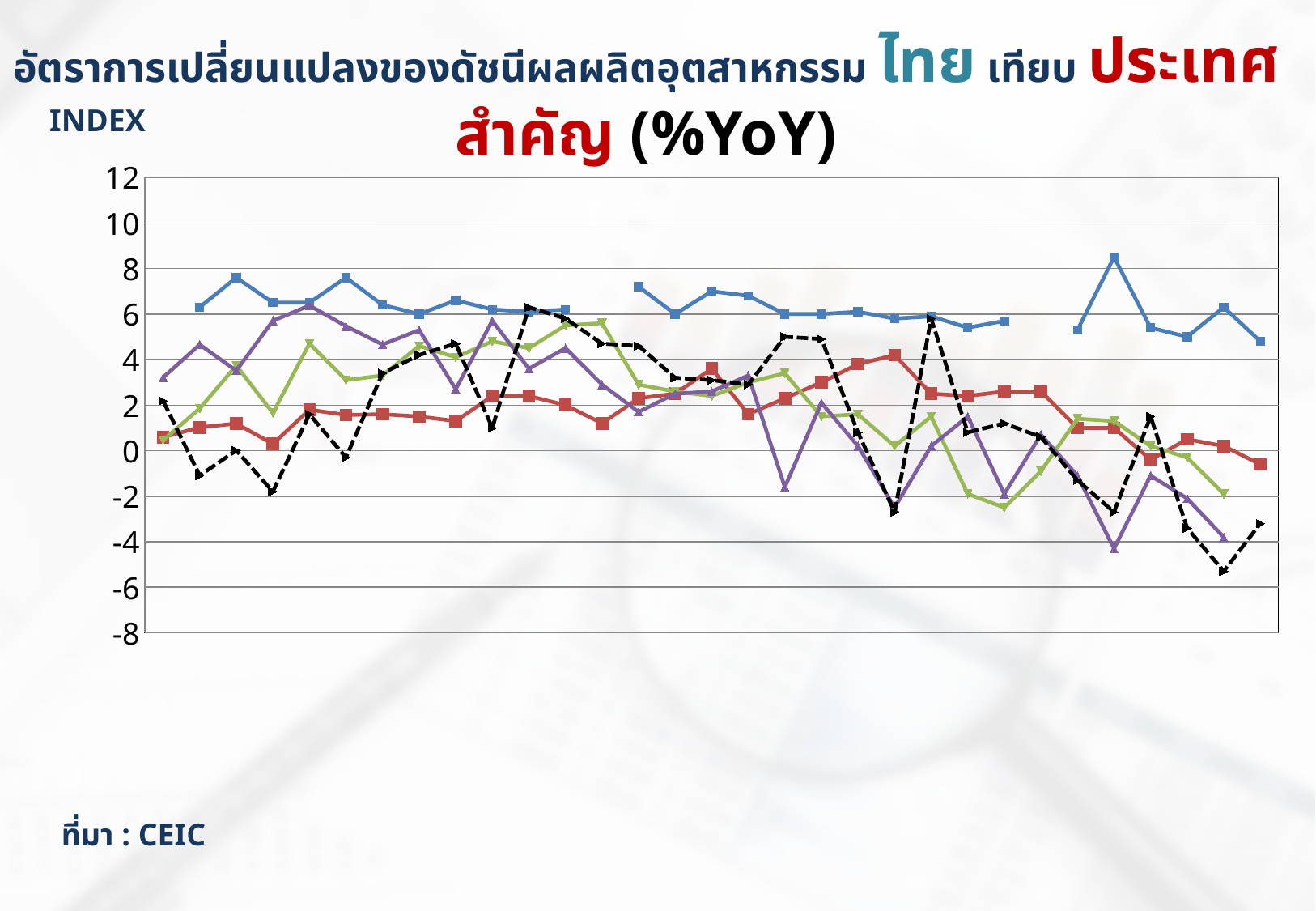
Does the green line end higher or lower than it starts? lower Is the lowest point of the purple line greater or less than -2? less Is the lowest point of the black dashed line greater or less than -4? less Is the lowest point of the blue line greater or less than 4? greater Does the red line rise or fall over the last few points on the right of the chart? fall What source is cited at the bottom of the slide? CEIC Which coloured line reaches the lowest point on the chart? black dashed Which coloured line sits highest across most of the chart? blue What is the highest value shown on the vertical axis? 12 What kind of chart is shown on the slide? line chart How many lines are plotted on the chart? 5